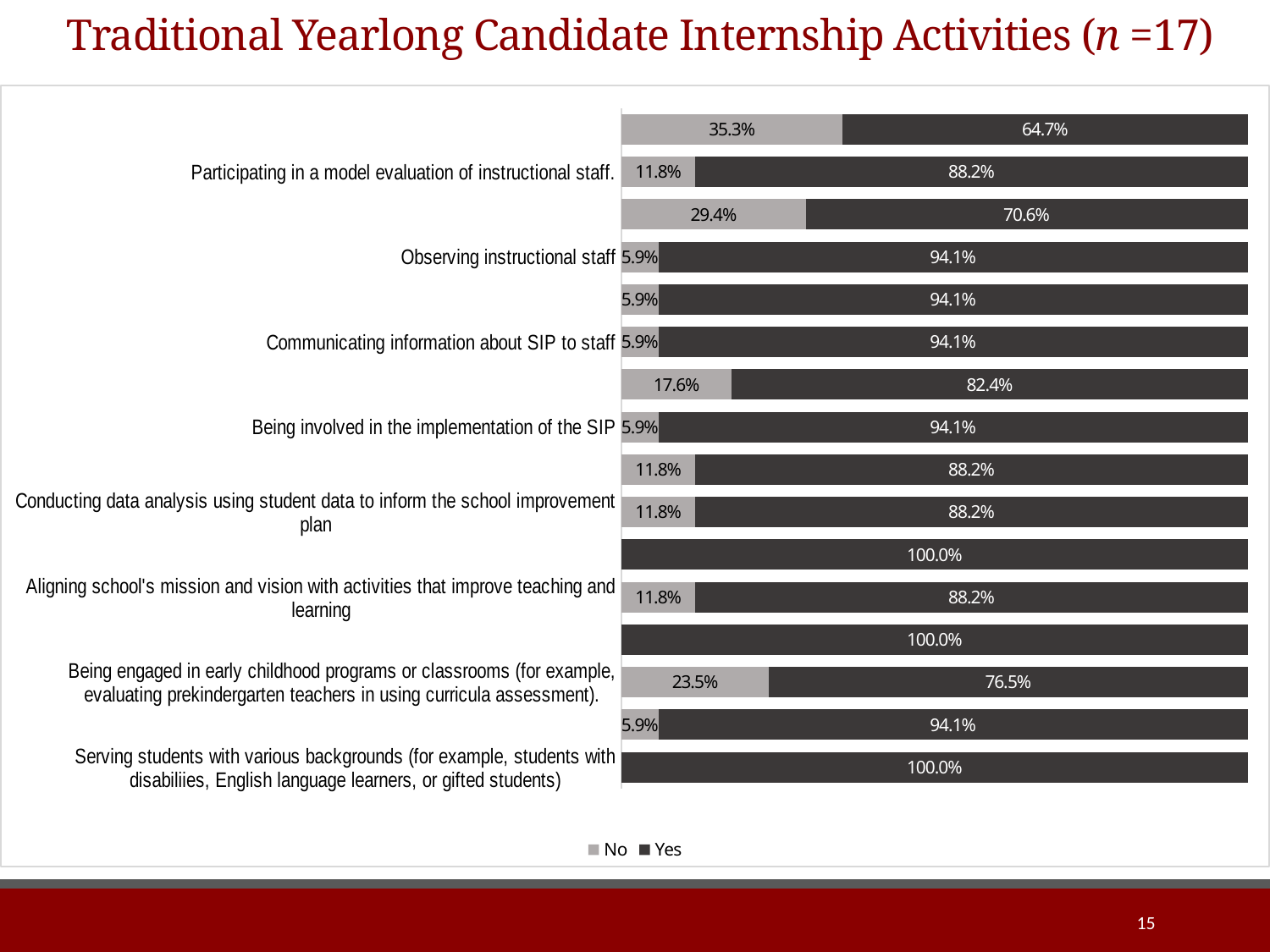
What is the Yes percentage for "Participating in a model evaluation of instructional staff."? 88.2% How many series does the legend list? 2 What are the two legend entries? No, Yes What kind of chart is shown on the slide? Stacked bar chart What is the Yes percentage for "Communicating information about SIP to staff"? 94.1% For "Being engaged in early childhood programs or classrooms", how much larger is the Yes percentage than the No percentage? 53.0% What is the No percentage for "Aligning school's mission and vision with activities that improve teaching and learning"? 11.8% What is the Yes percentage for "Serving students with various backgrounds"? 100.0% What is the total of the stacked bar for "Conducting data analysis using student data to inform the school improvement plan"? 100.0% Which has a higher Yes percentage: "Observing instructional staff" or "Participating in a model evaluation of instructional staff."? Observing instructional staff What is the No percentage for "Observing instructional staff"? 5.9% What is the No percentage for "Being engaged in early childhood programs or classrooms"? 23.5%